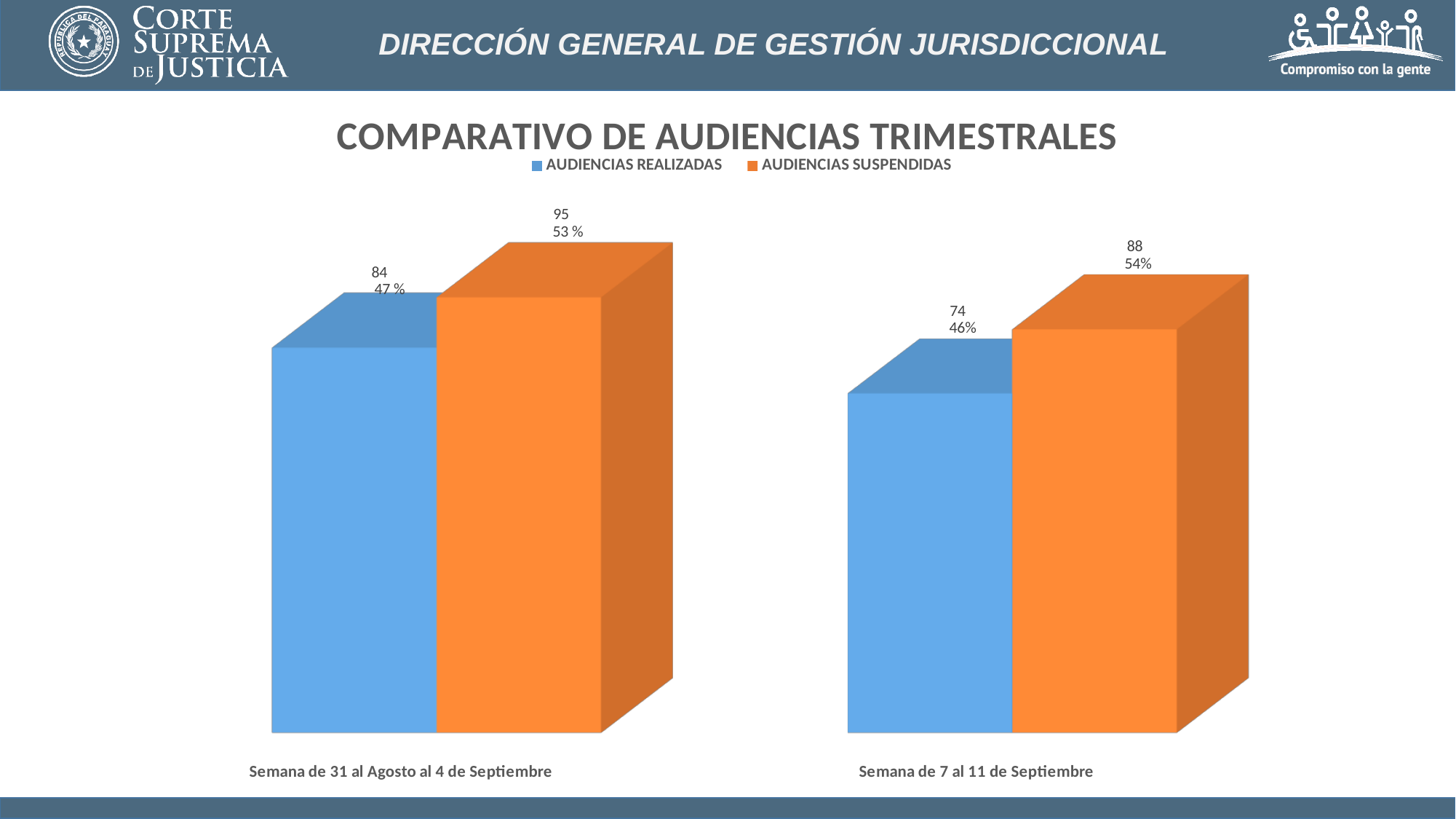
What is the title of the chart? COMPARATIVO DE AUDIENCIAS TRIMESTRALES How many series does the legend list? 2 What is the difference between AUDIENCIAS SUSPENDIDAS and AUDIENCIAS REALIZADAS in the week 'Semana de 7 al 11 de Septiembre'? 14 What percentage is shown for AUDIENCIAS REALIZADAS in the week 'Semana de 7 al 11 de Septiembre'? 46% What percentage is shown for AUDIENCIAS SUSPENDIDAS in the week 'Semana de 31 al Agosto al 4 de Septiembre'? 53 % What kind of chart is shown on the slide? Bar chart Which is larger: AUDIENCIAS REALIZADAS in 'Semana de 31 al Agosto al 4 de Septiembre' or AUDIENCIAS REALIZADAS in 'Semana de 7 al 11 de Septiembre'? Semana de 31 al Agosto al 4 de Septiembre What is the value for AUDIENCIAS REALIZADAS in the week 'Semana de 31 al Agosto al 4 de Septiembre'? 84 What is the difference between AUDIENCIAS SUSPENDIDAS and AUDIENCIAS REALIZADAS in the week 'Semana de 31 al Agosto al 4 de Septiembre'? 11 Which series has the highest value in the week 'Semana de 31 al Agosto al 4 de Septiembre'? AUDIENCIAS SUSPENDIDAS Which bar has the lowest value on the chart? AUDIENCIAS REALIZADAS in Semana de 7 al 11 de Septiembre What is the value for AUDIENCIAS SUSPENDIDAS in the week 'Semana de 7 al 11 de Septiembre'? 88